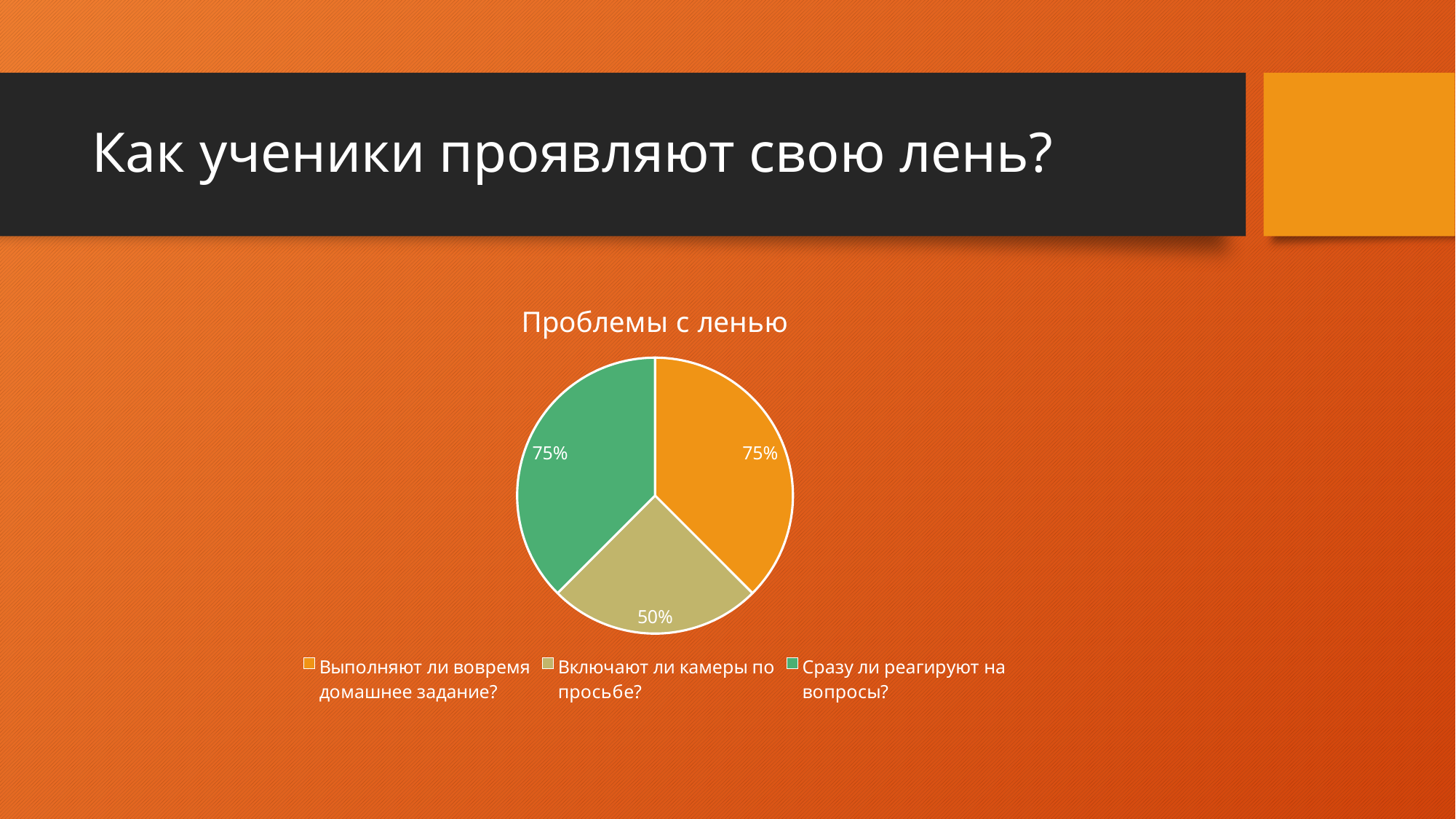
What type of chart is shown on the slide? Pie chart Which category is shown in green in the pie chart? Сразу ли реагируют на вопросы? What is the difference between the labelled values for "Сразу ли реагируют на вопросы?" and "Включают ли камеры по просьбе?"? 25% What value is labelled on the slice for "Сразу ли реагируют на вопросы?"? 75% What value is labelled on the slice for "Выполняют ли вовремя домашнее задание?"? 75% Which category has the smallest slice in the pie chart? Включают ли камеры по просьбе? Which is larger: the slice for "Выполняют ли вовремя домашнее задание?" or the slice for "Включают ли камеры по просьбе?"? Выполняют ли вовремя домашнее задание? How many slices does the pie chart have? 3 What value is labelled on the slice for "Включают ли камеры по просьбе?"? 50% What is the title of the chart? Проблемы с ленью How many entries does the legend list? 3